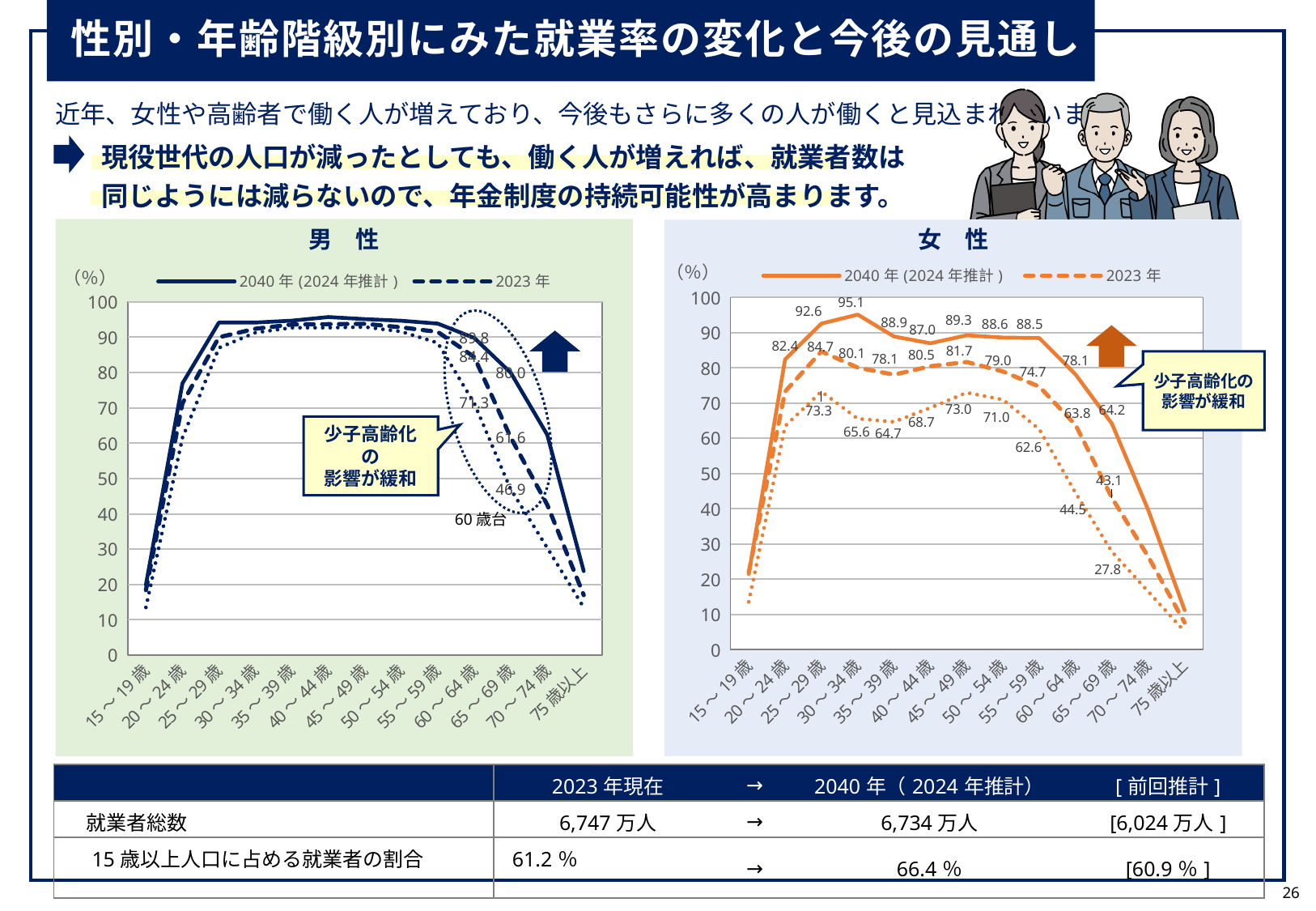
In the 女性 chart, does the 2040年(2024年推計) line rise or fall from 55～59歳 to 75歳以上? fall What are the two legend entries of the 男性 chart? 2040年(2024年推計) and 2023年 In the 女性 chart, what is the difference between the 2040年(2024年推計) value and the 2023年 value for 65～69歳? 21.1 How many series does the legend of the 女性 chart list? 2 What kind of chart is the 男性 chart on the left? line chart In the 女性 chart, what is the 2040年(2024年推計) value for 30～34歳? 95.1 In the 女性 chart, for 60～64歳, which series has the larger value: 2040年(2024年推計) or 2023年? 2040年(2024年推計) In the 女性 chart, what is the 2023年 value for 65～69歳? 43.1 How many age-group categories are shown on the x axis of the 女性 chart? 13 In the 男性 chart, is the 2040年(2024年推計) value for 75歳以上 greater or less than 30? less In the 女性 chart, what is the 2040年(2024年推計) value for 25～29歳? 92.6 In the 女性 chart, which age group has the highest 2040年(2024年推計) value? 30～34歳